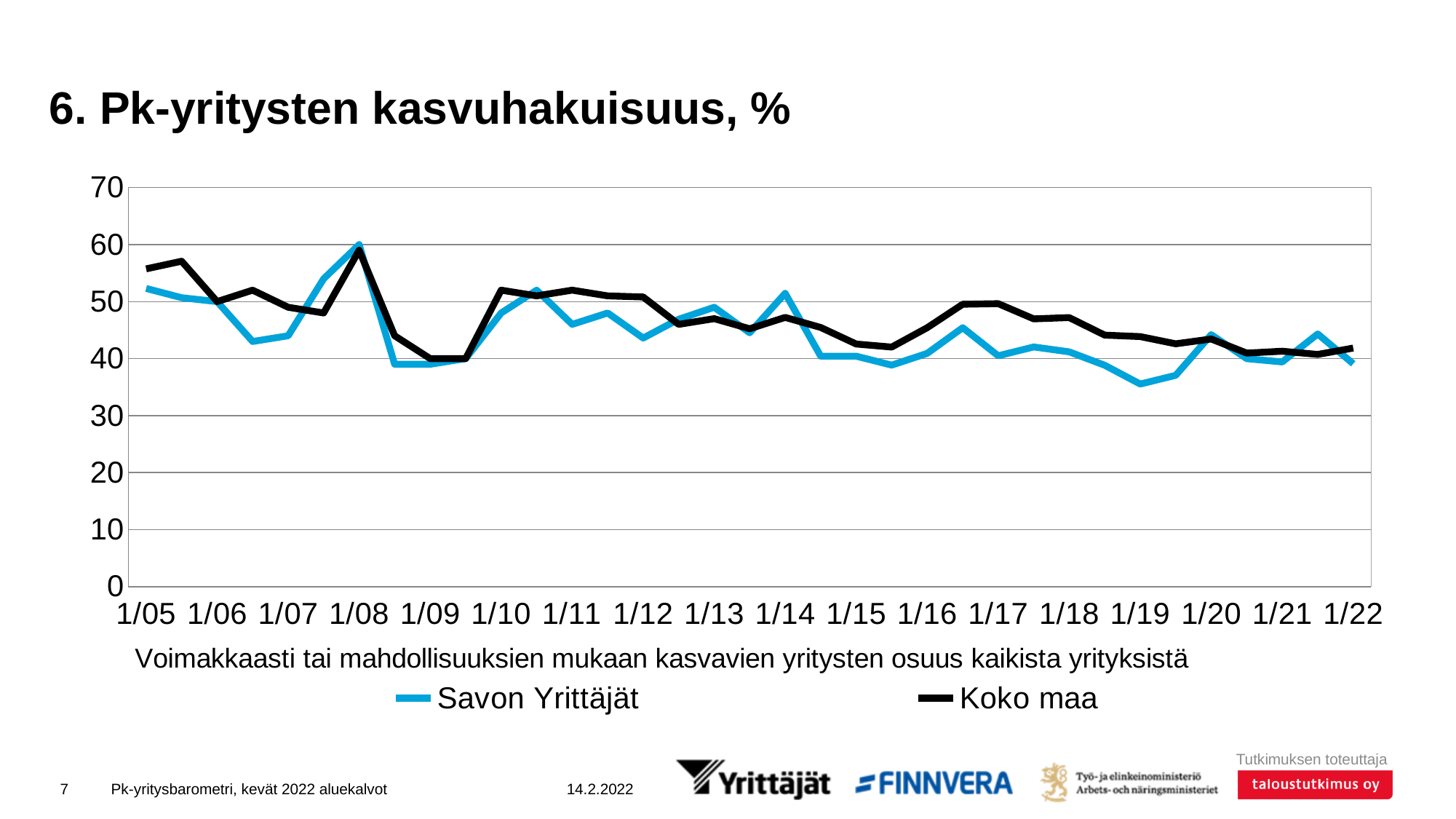
Is the value for Savon Yrittäjät at 1/19 greater or less than 40? less At 1/19, which series has the higher value, Savon Yrittäjät or Koko maa? Koko maa What kind of chart is shown on the slide? line chart Is the value for Koko maa at 1/05 greater or less than 50? greater Is the value for Koko maa at 1/09 greater or less than 50? less How many year labels are shown on the x axis? 18 How many series does the legend list? 2 What colour is the Savon Yrittäjät line? blue Overall, does the Koko maa line rise or fall from 1/05 to 1/22? fall At 1/05, which series has the higher value, Savon Yrittäjät or Koko maa? Koko maa